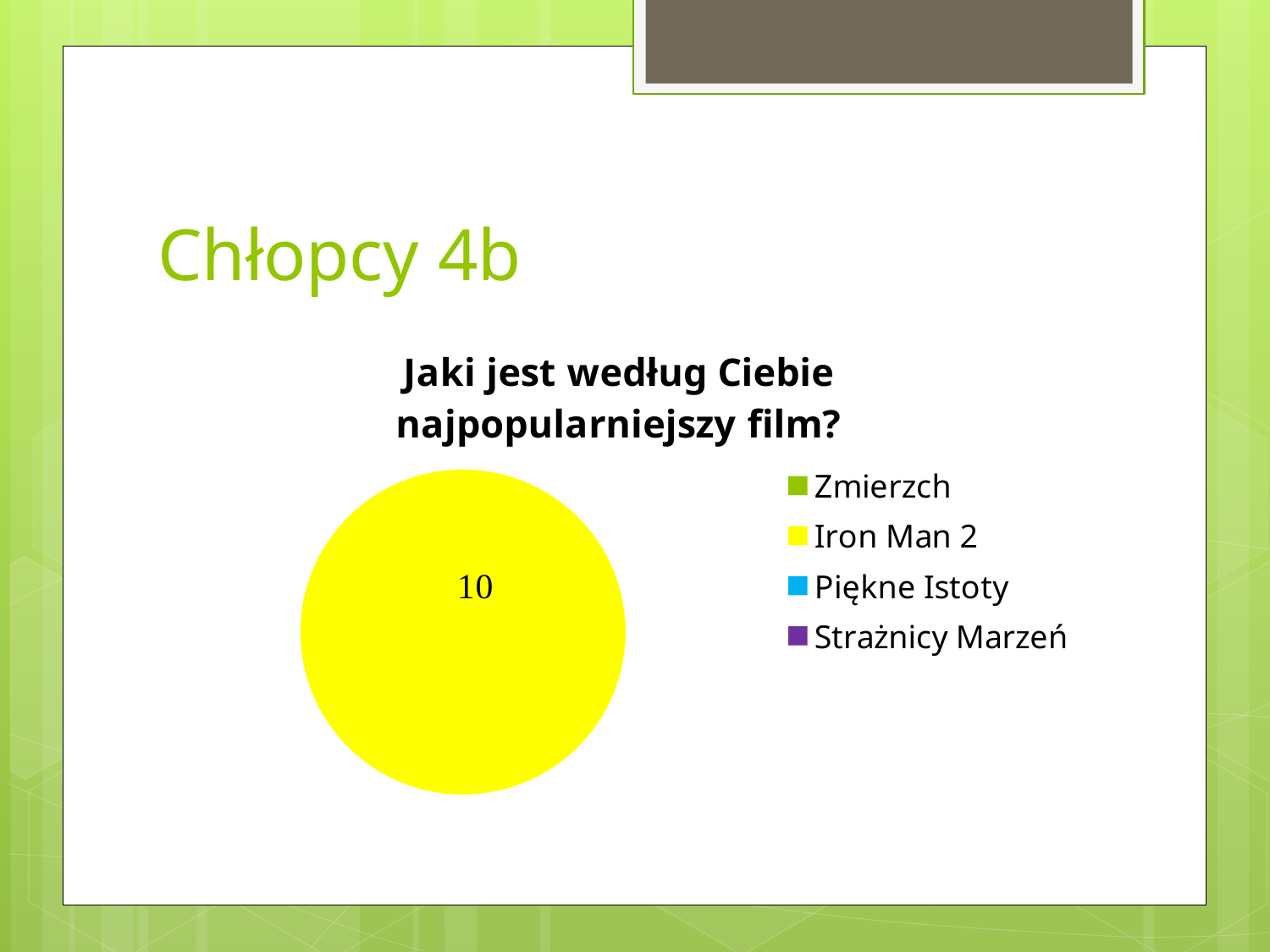
What kind of chart is shown on the slide? pie chart How many entries does the legend of the pie chart list? 4 What value is printed on the pie chart slice for Iron Man 2? 10 How many data labels are printed on the pie chart? 1 Which film has the largest slice in the pie chart? Iron Man 2 Which colour represents Iron Man 2 in the pie chart legend? yellow What is the title of the pie chart? Jaki jest według Ciebie najpopularniejszy film?